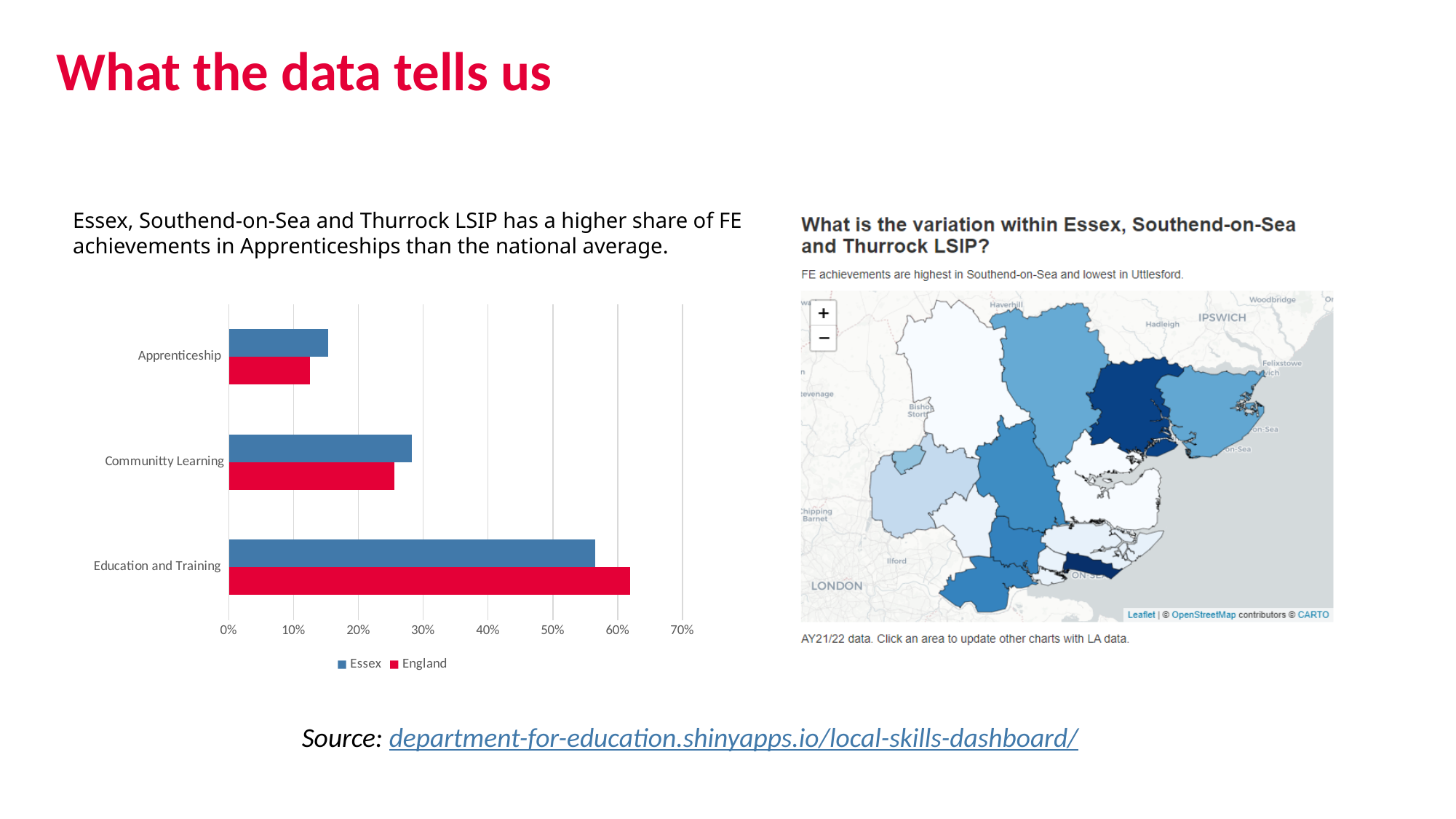
Is the Essex value for Education and Training greater or less than 50%? greater Is the England value for Apprenticeship greater or less than 20%? less Which series is shown in red in the bar chart? England Which category has the lowest value for England in the bar chart? Apprenticeship How many categories does the bar chart show? 3 What kind of chart is shown on the left of the slide? bar chart Is the England value for Education and Training greater or less than 60%? greater How many series does the bar chart's legend list? 2 For Apprenticeship, which is larger: the Essex value or the England value? Essex Which category has the highest value for Essex in the bar chart? Education and Training For Education and Training, which is larger: the Essex value or the England value? England